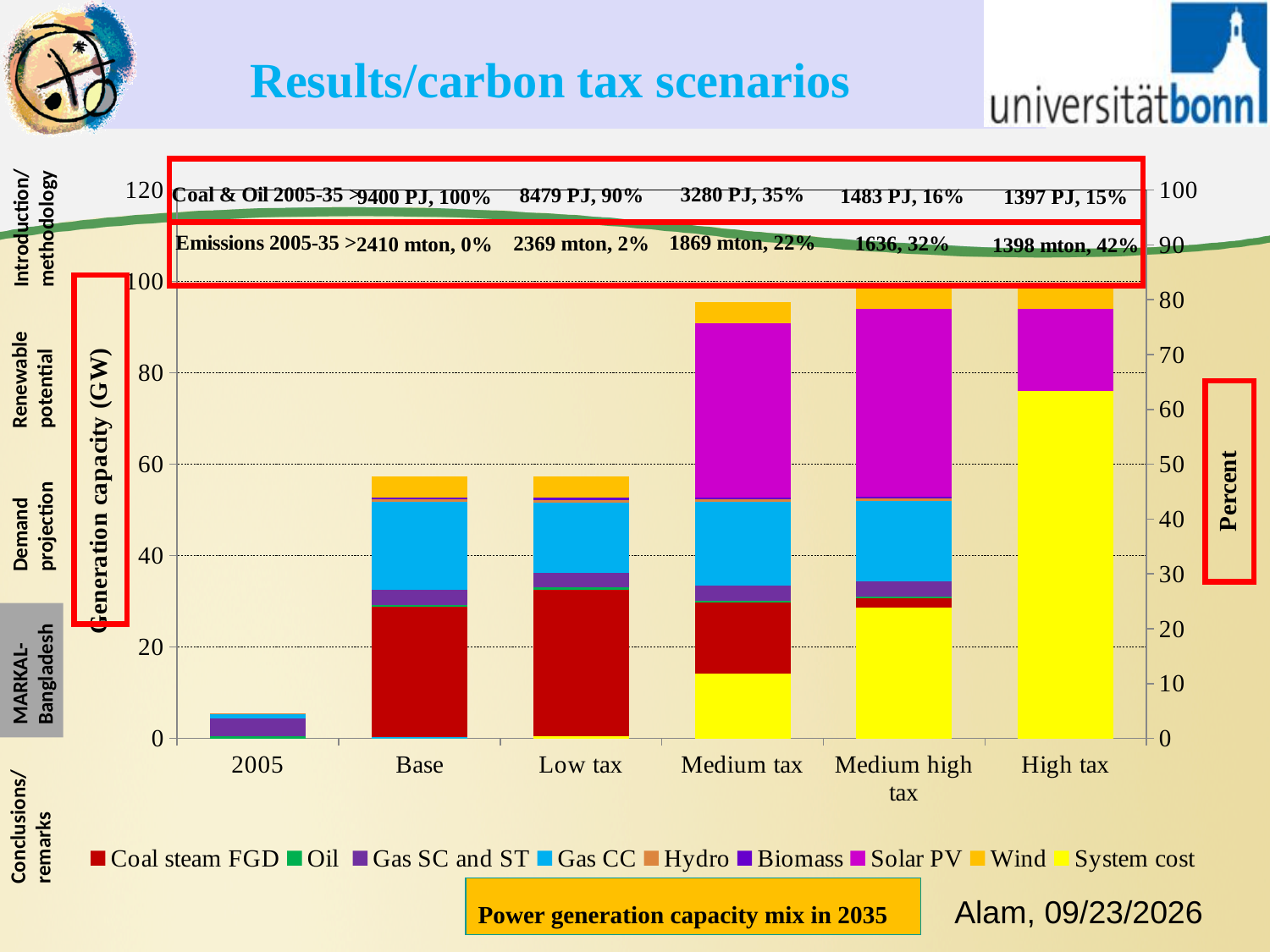
How many series does the chart legend list? 9 Is the total stacked value for 2005 greater or less than 20 GW? less Is the total stacked value for Medium tax greater or less than 80 GW? greater What kind of chart is shown on the slide? stacked bar chart Is the total stacked value for Base greater or less than 60 GW? less What is the title of the right vertical axis of the chart? Percent Which has the larger total stacked bar, 2005 or Base? Base How many scenario categories are shown along the x axis of the chart? 6 What is the title of the left vertical axis of the chart? Generation capacity (GW) Which category has the lowest total stacked bar in the chart? 2005 Which has the larger total stacked bar, Base or Medium tax? Medium tax